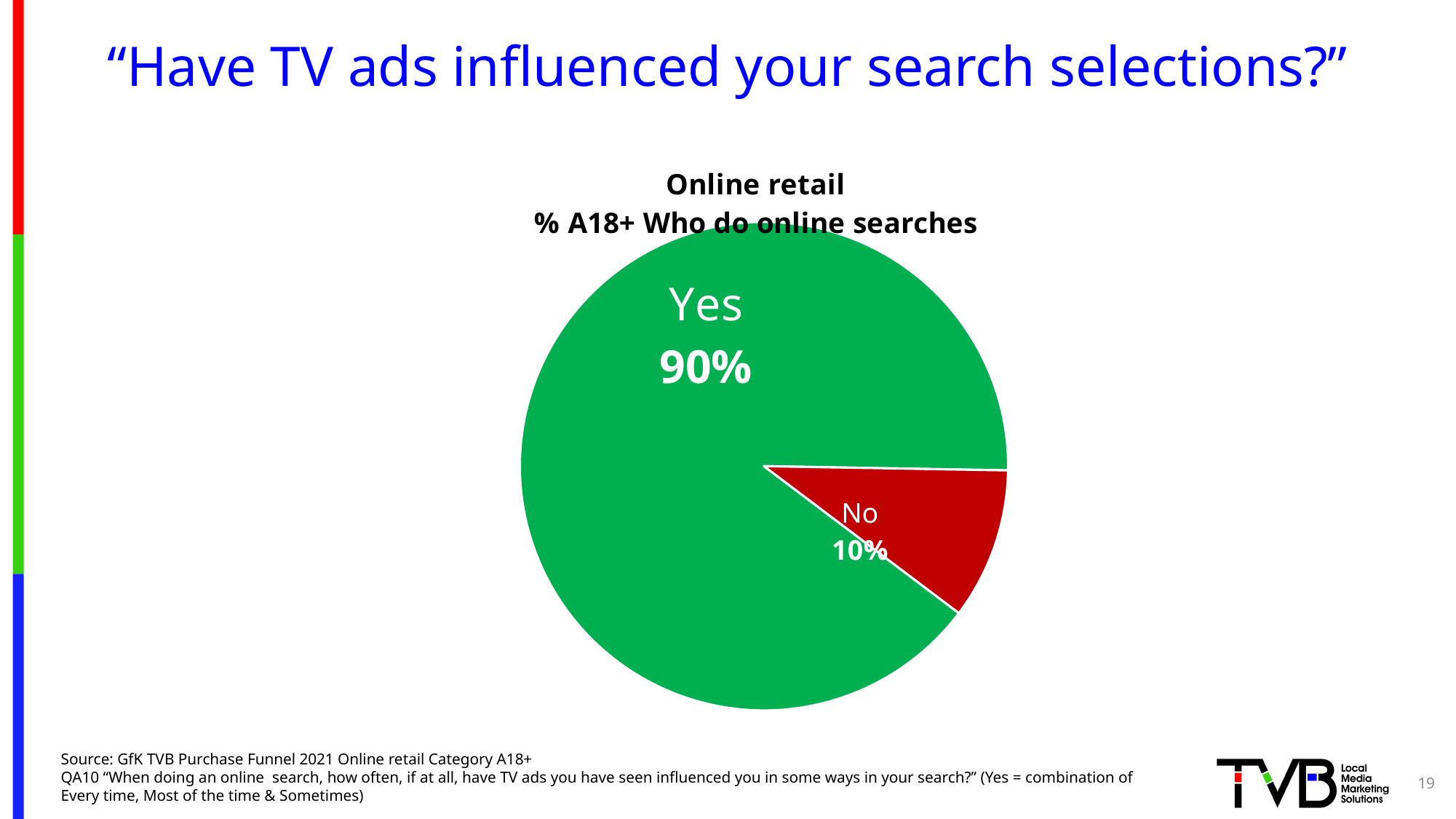
What percentage of respondents answered No? 10% What share of the pie does the No slice represent? 10% What is the title of the chart? Online retail % A18+ Who do online searches Which is larger, the Yes share or the No share? Yes What kind of chart is shown on the slide? pie chart Which response has the largest share of the pie? Yes What is the difference in percentage points between the Yes and No shares? 80 How many slices does the pie chart have? 2 What colour is the Yes slice? green What percentage of respondents answered Yes? 90% Which response has the smallest share of the pie? No Is the Yes share greater or less than 50%? greater